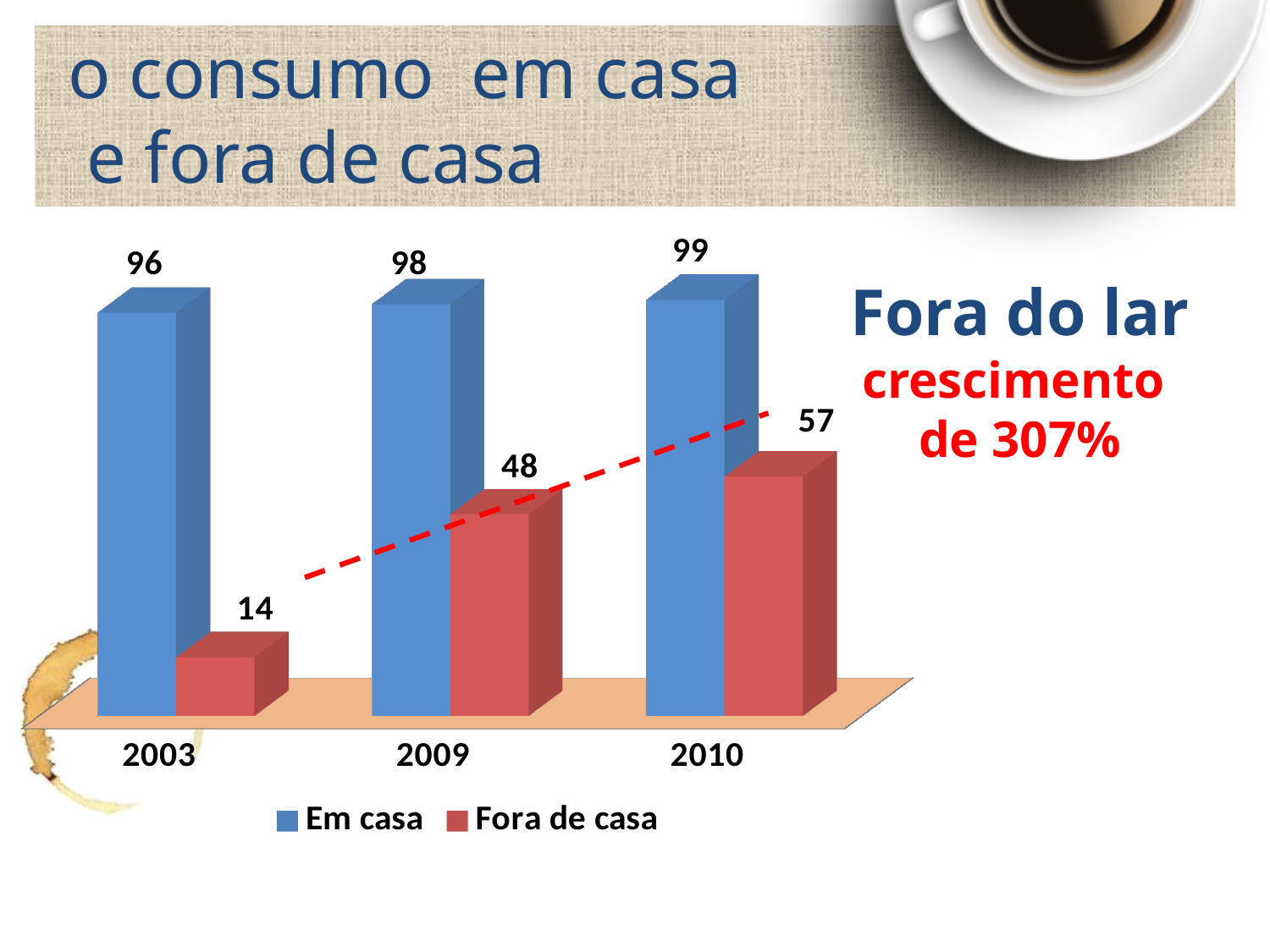
Which is larger in 2010, Em casa or Fora de casa? Em casa What is the value for Fora de casa in 2010? 57 What is the difference between the Em casa and Fora de casa values in 2003? 82 In which year is the Em casa value highest? 2010 What is the value for Fora de casa in 2009? 48 How many series does the legend list? 2 Do the Fora de casa values rise or fall from 2003 to 2010? Rise What kind of chart is shown on the slide? Bar chart In which year is the Fora de casa value lowest? 2003 How many years are shown on the x axis? 3 By how much did the Fora de casa value increase from 2003 to 2010? 43 What is the value for Em casa in 2003? 96